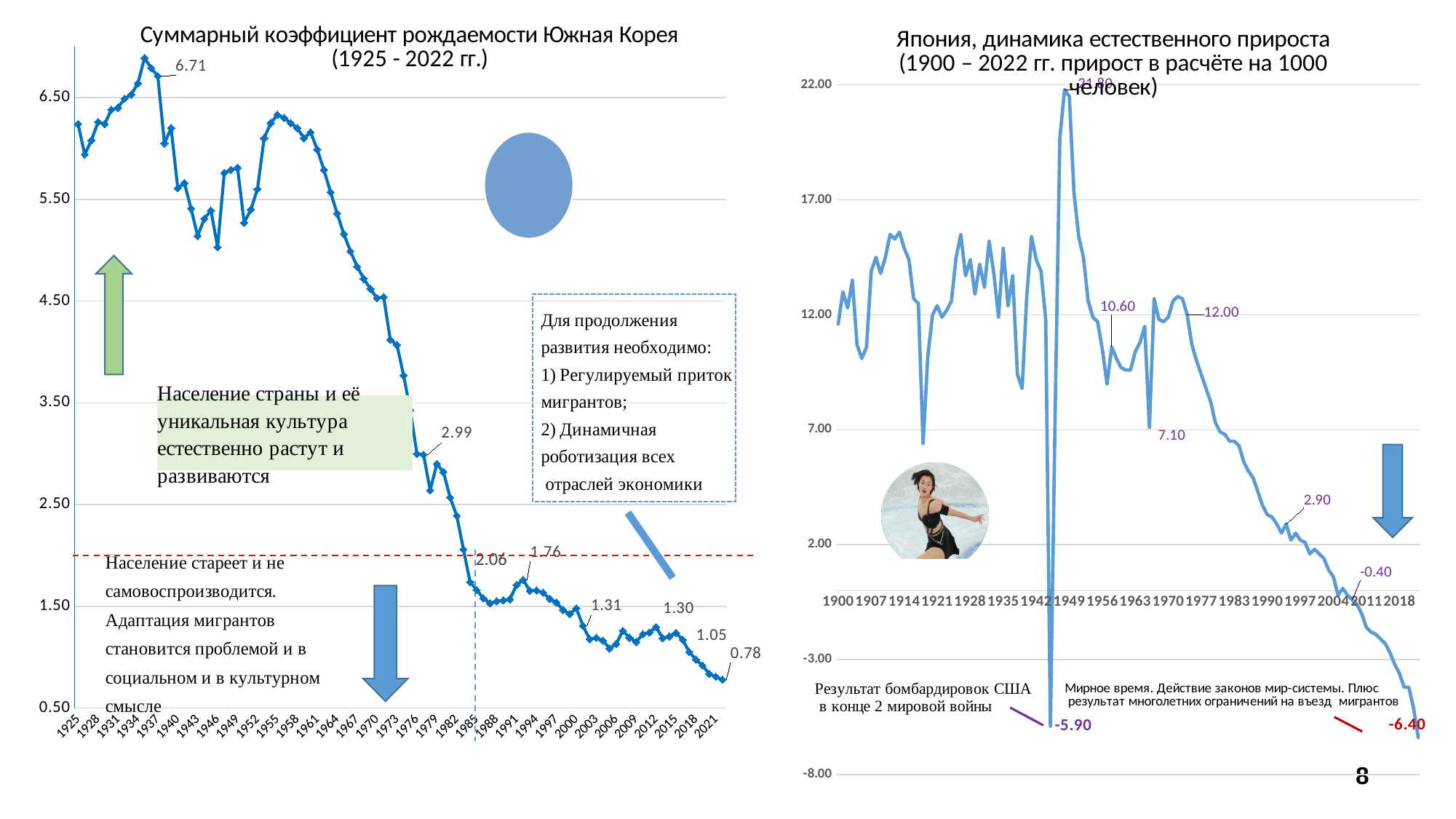
In the left chart (South Korea fertility rate), what is the difference between the peak value 6.71 and the final value 0.78? 5.93 In the right chart (Japan natural increase), what is the difference between the labelled values 12.00 and 7.10? 4.90 In the right chart (Japan natural increase), what labelled value is shown at the sharp dip around 1945? -5.90 What type of chart is the left chart, 'Суммарный коэффициент рождаемости Южная Корея (1925 - 2022 гг.)'? line chart In the left chart (South Korea fertility rate), which labelled value is larger: 2.99 or 2.06? 2.99 In the left chart (South Korea fertility rate), what is the highest labelled value? 6.71 In the left chart (South Korea fertility rate), do the values overall rise or fall from 1925 to 2022? fall In the left chart (South Korea fertility rate), what is the lowest labelled value, at the end of the series? 0.78 What type of chart is the right chart, 'Япония, динамика естественного прироста'? line chart In the right chart (Japan natural increase), what is the lowest labelled value, at the end of the series? -6.40 In the left chart (South Korea fertility rate), is the value for 1925 greater or less than 5.50? greater In the right chart (Japan natural increase), is the value for 1900 greater or less than 7.00? greater